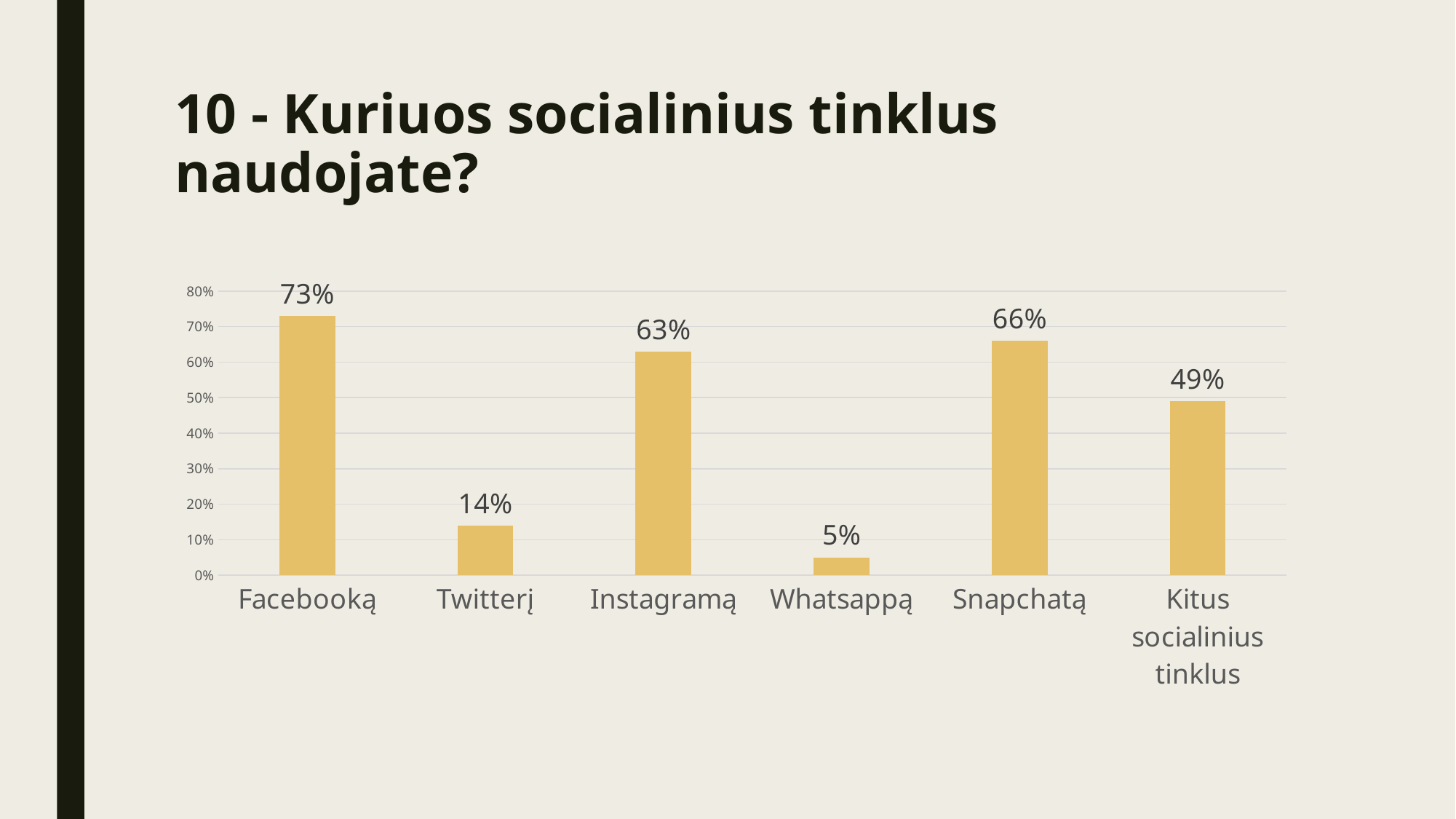
What is the value for Facebooką? 73% What is the title of the slide? 10 - Kuriuos socialinius tinklus naudojate? How many categories are shown on the x axis? 6 What is the difference between the values for Snapchatą and Twitterį? 52% Which category has the highest value? Facebooką What is the value for Kitus socialinius tinklus? 49% What kind of chart is shown on the slide? Bar chart Which category has the lowest value? Whatsappą Which is larger, the value for Snapchatą or the value for Instagramą? Snapchatą What is the value for Whatsappą? 5% What is the value for Twitterį? 14% What is the difference between the values for Facebooką and Instagramą? 10%